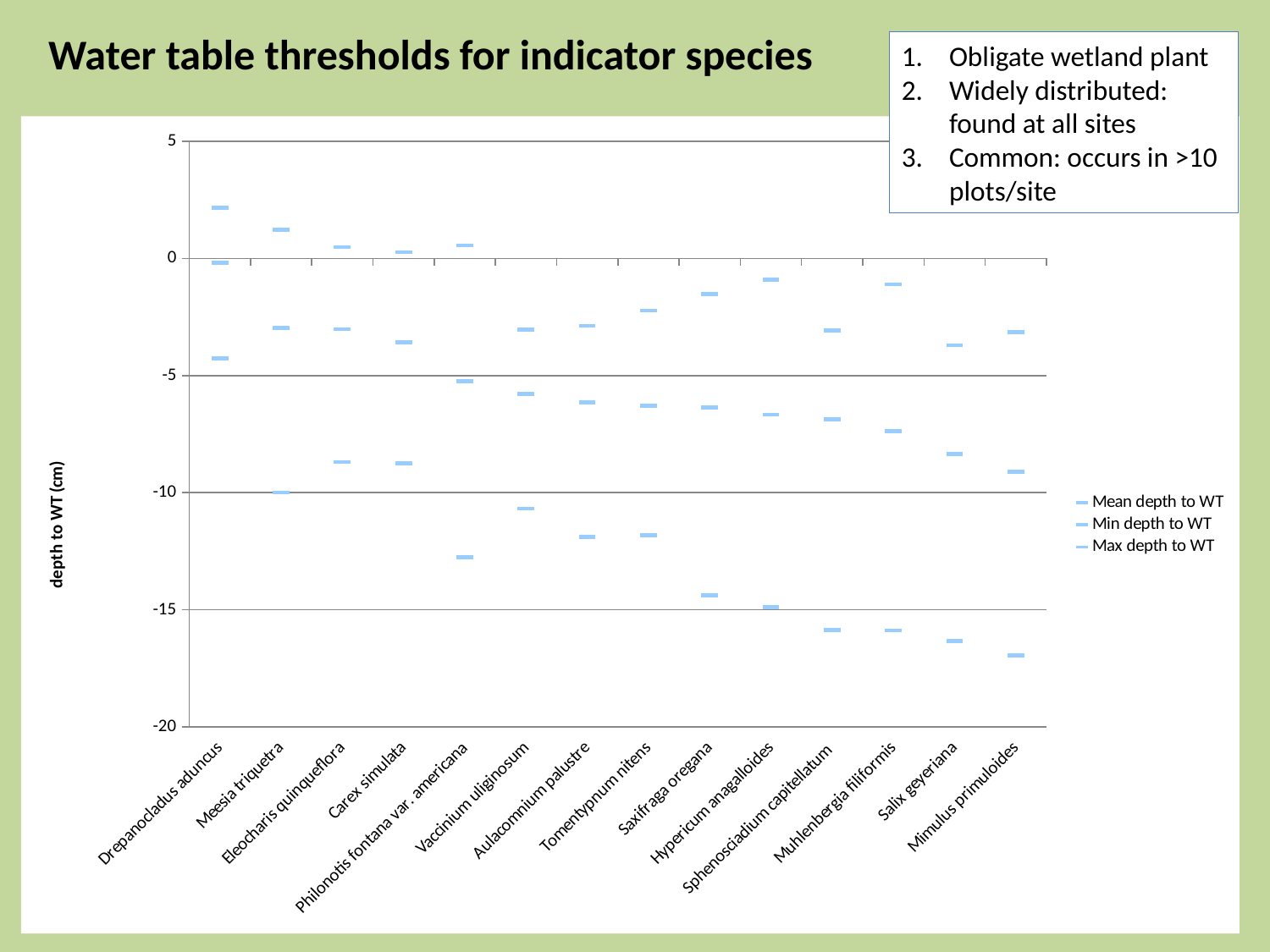
Which species has a higher lowest plotted value, Drepanocladus aduncus or Salix geyeriana? Drepanocladus aduncus Is the highest plotted value for Saxifraga oregana greater or less than 0? less Which species has the highest plotted value on the chart? Drepanocladus aduncus What is the title of the y axis of the chart? depth to WT (cm) Is the lowest plotted value for Mimulus primuloides greater or less than -15? less Is the lowest plotted value for Drepanocladus aduncus greater or less than -5? greater How many species (categories) are shown on the x axis of the chart? 14 What are the three series named in the chart's legend? Mean depth to WT, Min depth to WT, Max depth to WT Moving from left to right along the x axis, do the lowest plotted values for each species generally rise or fall? fall How many series does the chart's legend list? 3